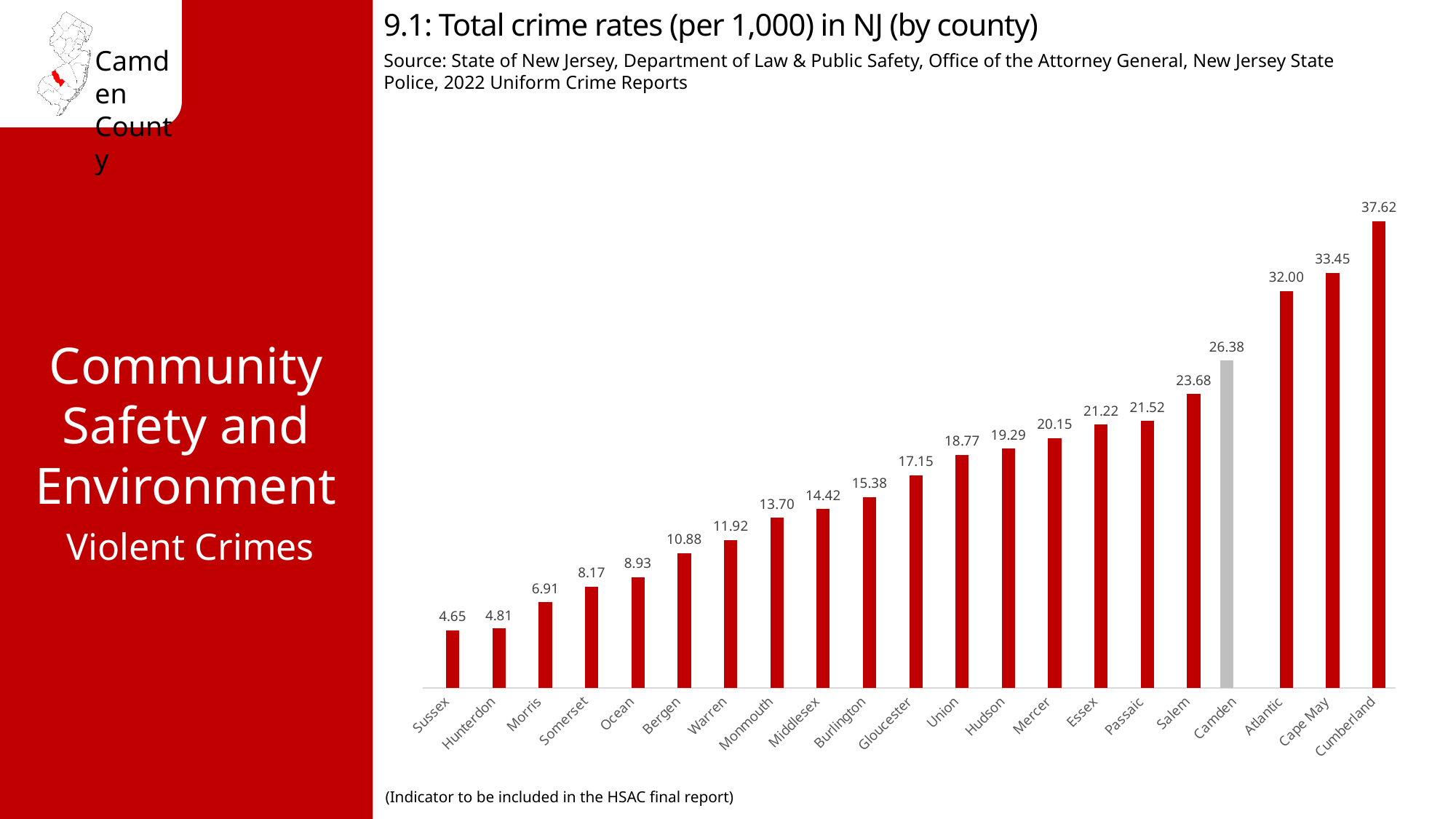
Do the values rise or fall moving from left to right along the x axis? Rise Which county has the lowest total crime rate? Sussex What type of chart is used to show the total crime rates? Bar chart What is the total crime rate (per 1,000) for Cape May County? 33.45 What is the difference between the total crime rates of Camden and Sussex? 21.73 What is the total crime rate (per 1,000) for Bergen County? 10.88 What is the difference between the total crime rates of Cumberland and Camden? 11.24 How many counties are shown in the chart? 21 What is the total crime rate (per 1,000) for Camden County? 26.38 Which county has a higher total crime rate, Atlantic or Salem? Atlantic Which county has the highest total crime rate? Cumberland Which county's bar is coloured grey instead of red? Camden